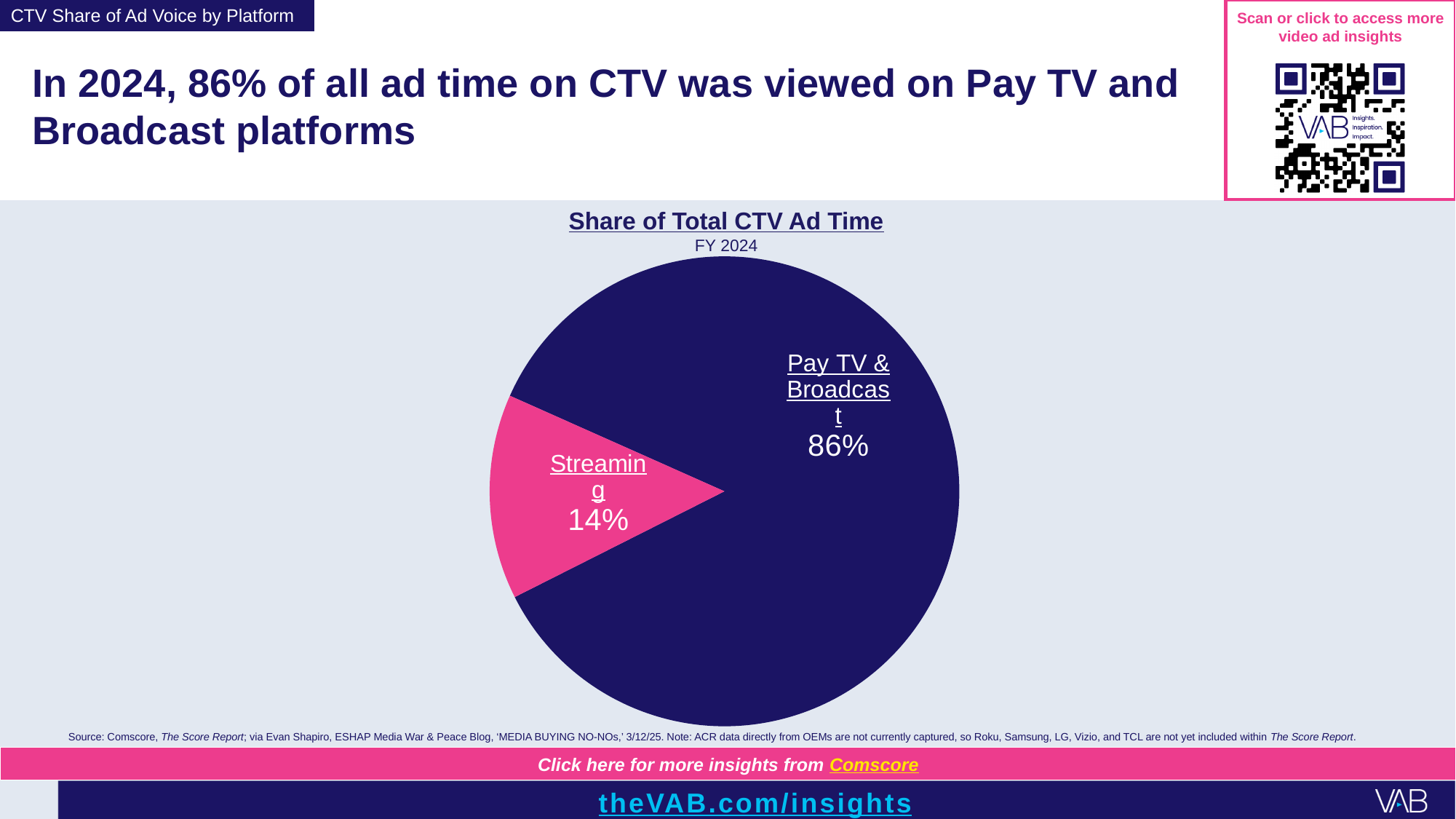
What is the title of the chart? Share of Total CTV Ad Time Which slice of the pie is the largest? Pay TV & Broadcast Which has a larger share of CTV ad time, Streaming or Pay TV & Broadcast? Pay TV & Broadcast What fiscal year does the chart cover? FY 2024 What is the difference in percentage points between the Pay TV & Broadcast share and the Streaming share? 72 percentage points What share of total CTV ad time does Streaming hold? 14% What is the combined share of the two slices in the pie chart? 100% How many slices does the pie chart have? 2 What share of total CTV ad time does Pay TV & Broadcast hold? 86% What kind of chart is shown on the slide? Pie chart Which slice of the pie is the smallest? Streaming